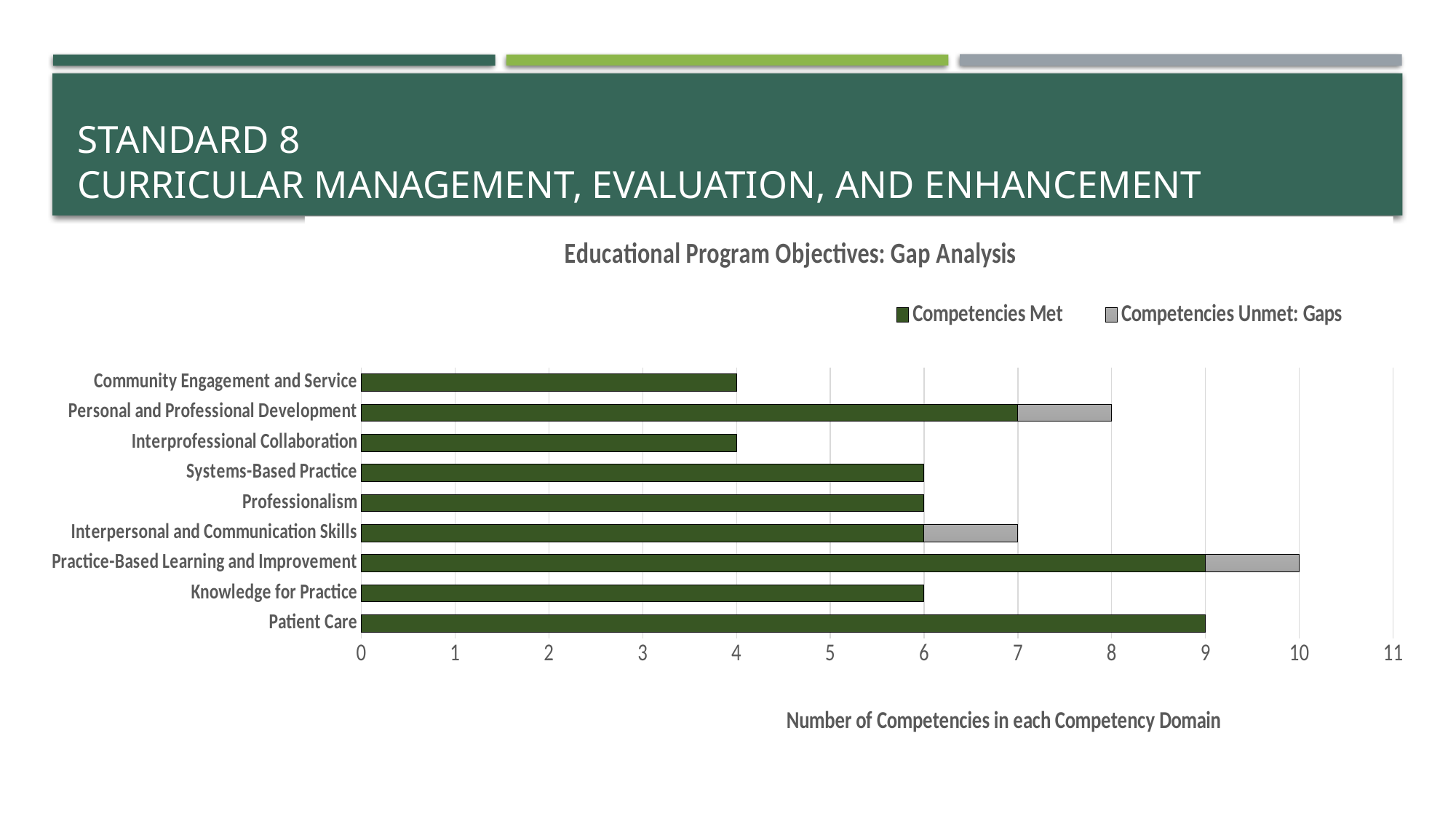
What is the total number of competencies (met plus unmet) for Practice-Based Learning and Improvement? 10 What is the difference in Competencies Met between Patient Care and Knowledge for Practice? 3 How many competency domains are listed on the chart? 9 How many series does the legend list? 2 Which has more Competencies Met, Systems-Based Practice or Interprofessional Collaboration? Systems-Based Practice What is the title of the chart? Educational Program Objectives: Gap Analysis How many Competencies Met are shown for Patient Care? 9 What type of chart is shown on the slide? Bar chart What is the total number of competencies (met plus unmet) for Interpersonal and Communication Skills? 7 How many Competencies Met are shown for Personal and Professional Development? 7 Which competency domain has the longest total bar? Practice-Based Learning and Improvement How many Competencies Met are shown for Community Engagement and Service? 4